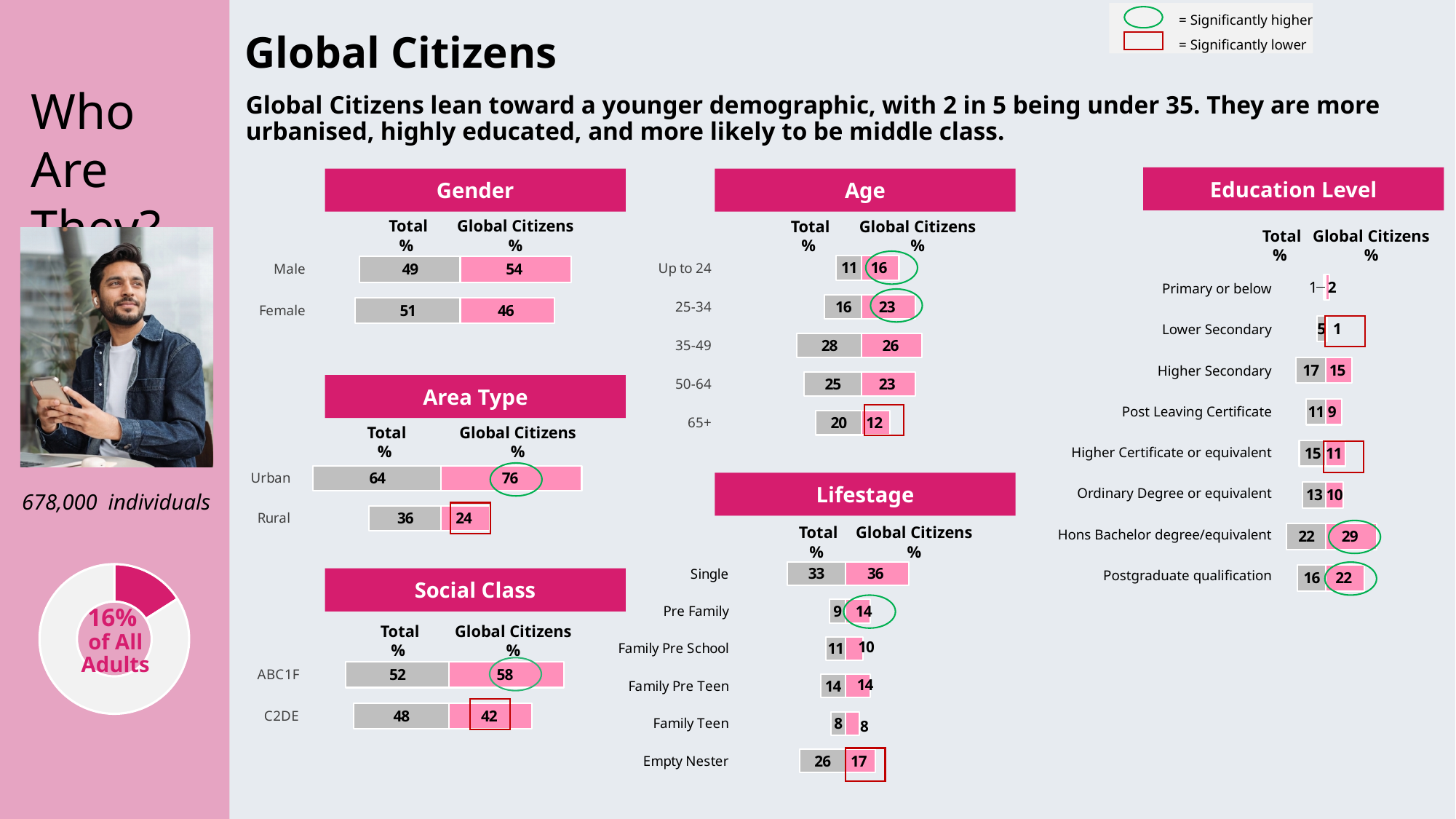
In the Education Level chart, what is the Global Citizens % for Hons Bachelor degree/equivalent? 29 In the Gender chart, what is the Global Citizens % for Male? 54 In the Area Type chart, what is the Total % for Urban? 64 What share of all adults does the donut chart on the left show for Global Citizens? 16% In the Lifestage chart, what is the Global Citizens % for Empty Nester? 17 In the Education Level chart, how many education levels are listed? 8 In the Lifestage chart, which lifestage has the highest Global Citizens %? Single In the Age chart, how many age groups are shown? 5 In the Area Type chart, what is the difference between the Global Citizens % for Urban and Rural? 52 In the Age chart, which age group has the lowest Total %? Up to 24 In the Social Class chart, which is larger for ABC1F: the Total % or the Global Citizens %? Global Citizens % In the Age chart, which age group has the highest Global Citizens %? 35-49